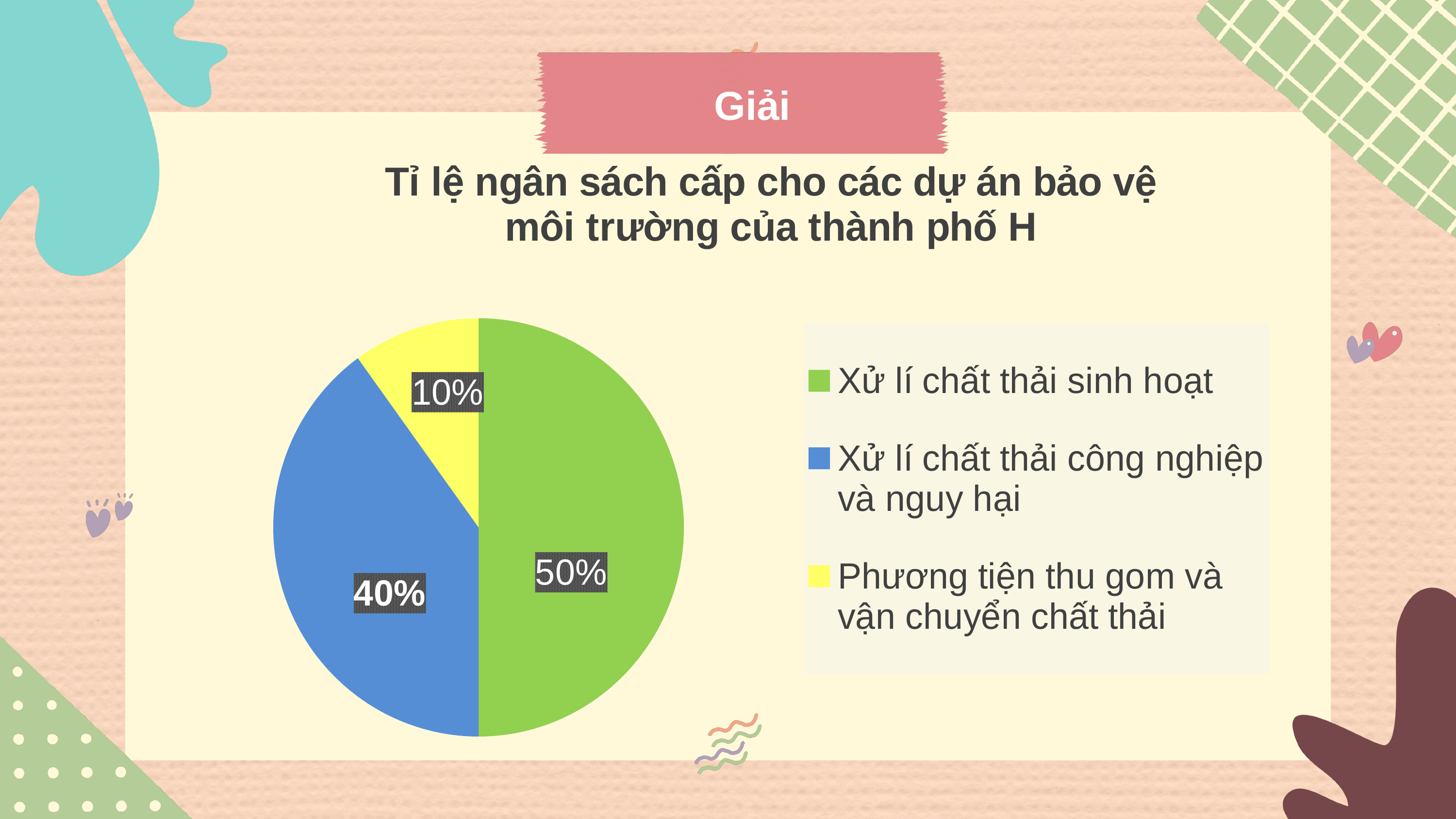
What share of the budget goes to Xử lí chất thải công nghiệp và nguy hại? 40% What share of the budget goes to Xử lí chất thải sinh hoạt? 50% How many categories does the pie chart have? 3 What colour is the slice for Phương tiện thu gom và vận chuyển chất thải? Yellow What is the title of the chart? Tỉ lệ ngân sách cấp cho các dự án bảo vệ môi trường của thành phố H What share of the budget goes to Phương tiện thu gom và vận chuyển chất thải? 10% What is the difference between the shares for Xử lí chất thải sinh hoạt and Xử lí chất thải công nghiệp và nguy hại? 10% What is the difference between the shares for Xử lí chất thải công nghiệp và nguy hại and Phương tiện thu gom và vận chuyển chất thải? 30% Which category has the smallest share of the pie? Phương tiện thu gom và vận chuyển chất thải What kind of chart is shown on the slide? Pie chart Which category has the largest share of the pie? Xử lí chất thải sinh hoạt Which is larger: the share for Xử lí chất thải công nghiệp và nguy hại or the share for Phương tiện thu gom và vận chuyển chất thải? Xử lí chất thải công nghiệp và nguy hại